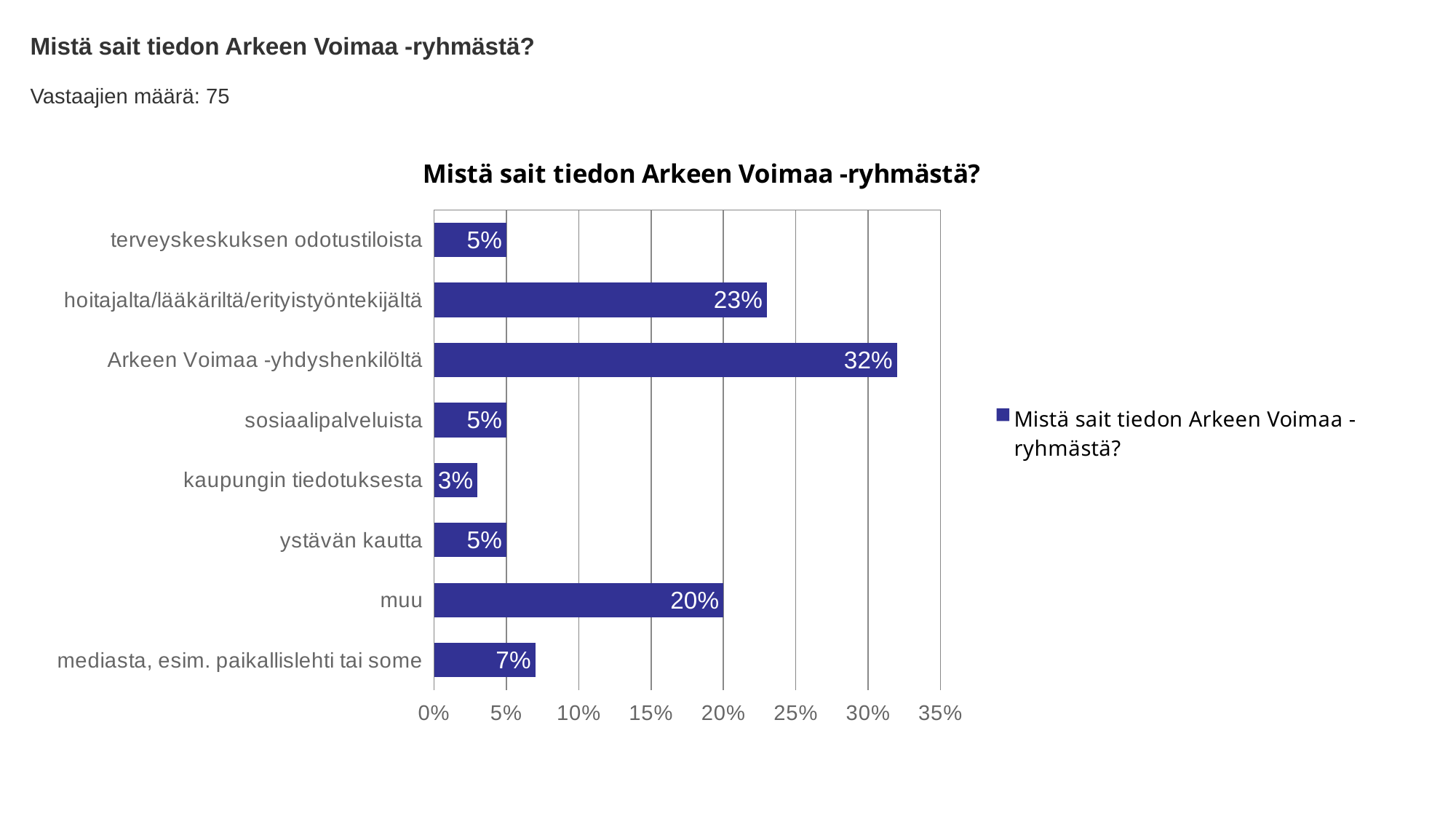
How many categories are shown in the chart? 8 Is the value for "hoitajalta/lääkäriltä/erityistyöntekijältä" greater or less than 20%? greater What kind of chart is shown on the slide? bar chart Which category has the lowest value? kaupungin tiedotuksesta What is the value for "muu"? 20% Which is larger, the value for "muu" or the value for "mediasta, esim. paikallislehti tai some"? muu Which category has the highest value? Arkeen Voimaa -yhdyshenkilöltä What is the difference between the values for "Arkeen Voimaa -yhdyshenkilöltä" and "hoitajalta/lääkäriltä/erityistyöntekijältä"? 9% What is the value for "mediasta, esim. paikallislehti tai some"? 7% What is the value for "hoitajalta/lääkäriltä/erityistyöntekijältä"? 23% What is the title of the chart? Mistä sait tiedon Arkeen Voimaa -ryhmästä? What is the value for "Arkeen Voimaa -yhdyshenkilöltä"? 32%